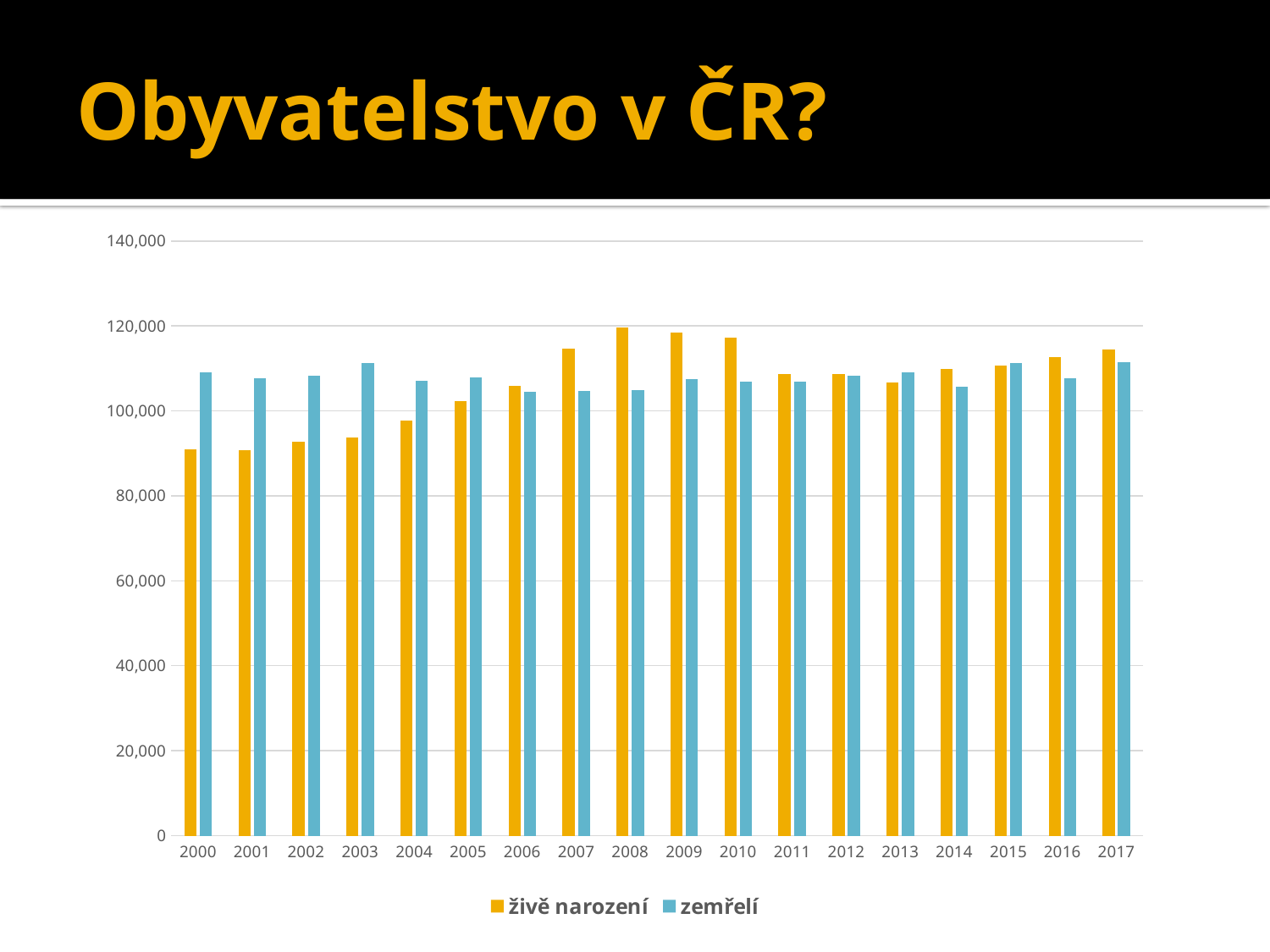
Do the values for živě narození rise or fall from 2000 to 2008? rise What kind of chart is shown on the slide? bar chart Is the value for živě narození in 2008 greater or less than 100,000? greater In 2000, which is larger: živě narození or zemřelí? zemřelí What are the two legend entries? živě narození, zemřelí Is the value for zemřelí in 2003 greater or less than 100,000? greater Is the value for živě narození in 2007 greater or less than 120,000? less Which series is shown in orange? živě narození How many series does the legend list? 2 In 2008, which is larger: živě narození or zemřelí? živě narození How many years are shown on the x axis? 18